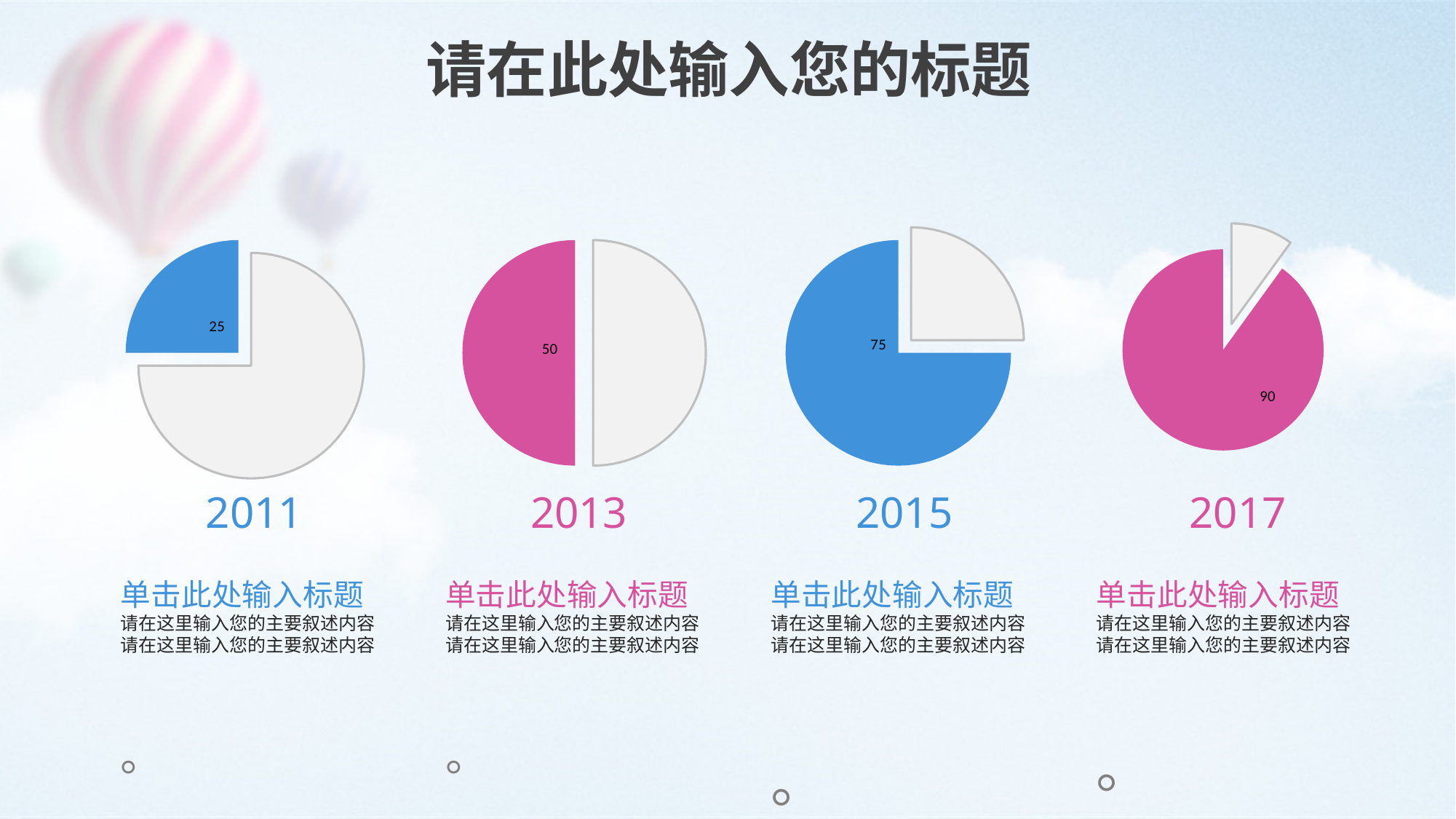
In the pie chart labelled 2013, what value is printed on the pink slice? 50 In the pie chart labelled 2011, what value is printed on the blue slice? 25 What colour is the labelled slice in the pie chart for 2015? Blue In the pie chart labelled 2017, what value is printed on the pink slice? 90 In the pie chart labelled 2015, what value is printed on the blue slice? 75 What is the difference between the labelled value in the 2017 pie chart and the labelled value in the 2011 pie chart? 65 Which year's pie chart has the largest labelled slice value? 2017 What kind of chart is used for each of the four years on the slide? Pie chart Which year's pie chart has the smallest labelled slice value? 2011 Which is larger: the labelled value in the 2013 pie chart or the labelled value in the 2015 pie chart? 2015 How many pie charts are shown on the slide? 4 Do the labelled slice values rise or fall from the 2011 chart to the 2017 chart? Rise